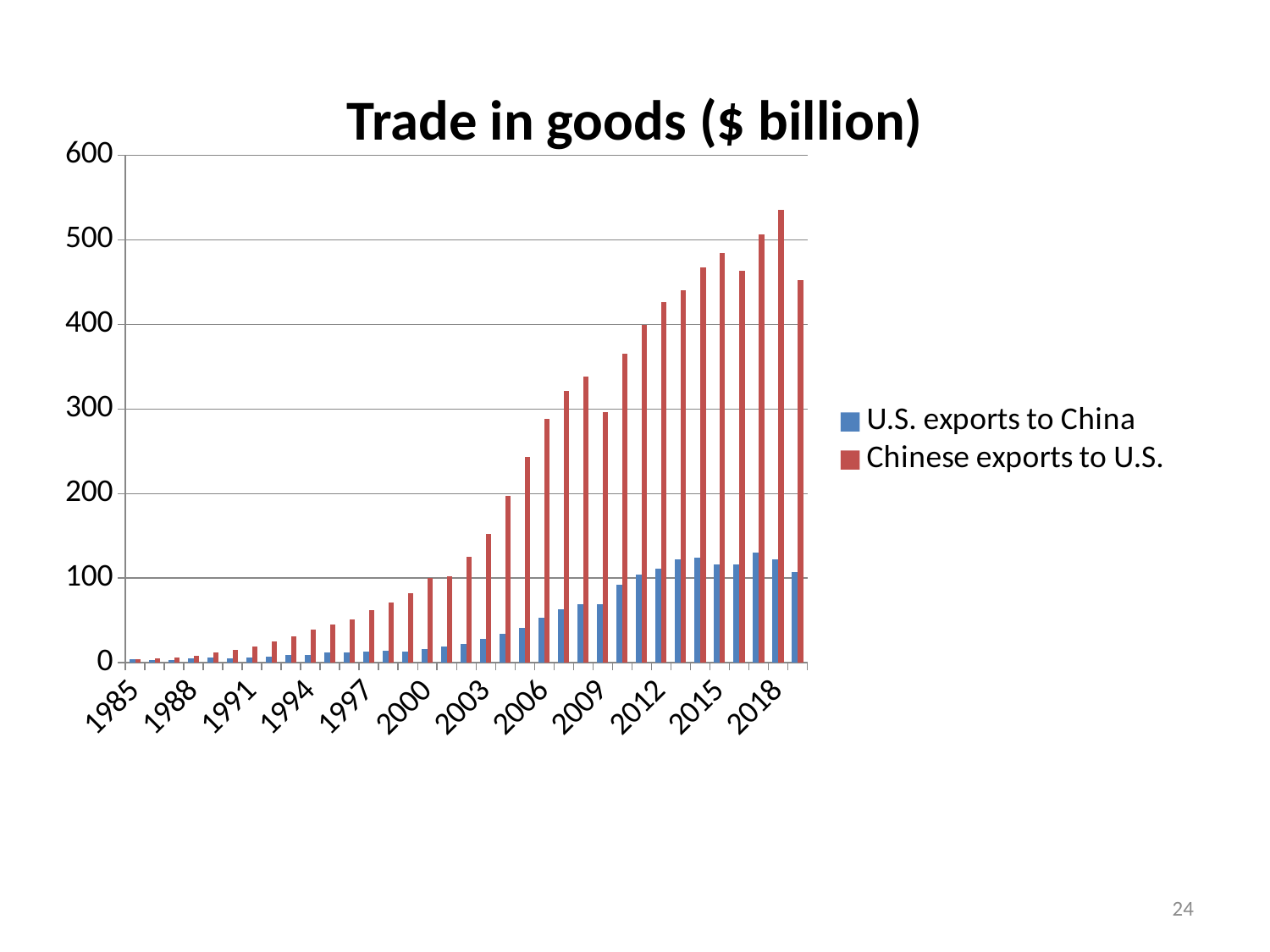
Which series is shown in red? Chinese exports to U.S. In which year is the value for Chinese exports to U.S. highest? 2018 Is the value for U.S. exports to China in 2018 greater or less than 200? less In 2018, which is larger: U.S. exports to China or Chinese exports to U.S.? Chinese exports to U.S. What is the title of the chart? Trade in goods ($ billion) Is the value for Chinese exports to U.S. in 2018 greater or less than 500? greater Is the value for Chinese exports to U.S. in 2012 greater or less than 400? greater What kind of chart is shown on the slide? bar chart Do the values for Chinese exports to U.S. generally rise or fall from 1985 to 2018? rise How many series does the legend list? 2